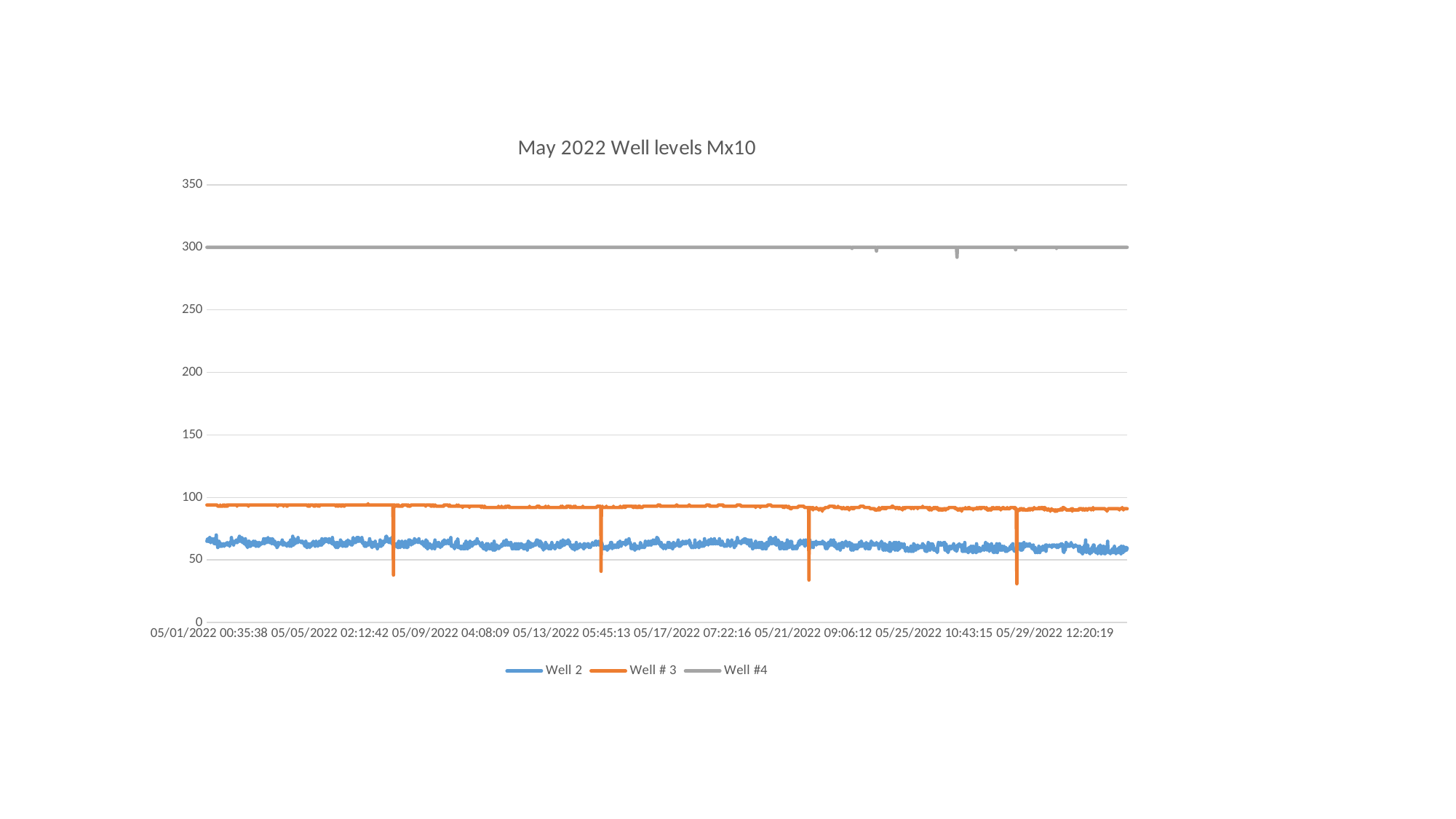
Which series has the highest values throughout the chart? Well #4 Is the typical value for Well 2 greater or less than 100? less Which series is larger, Well 2 or Well # 3? Well # 3 Which series has the lowest values throughout the chart? Well 2 How many date labels are shown on the x axis? 8 What is the title of the chart? May 2022 Well levels Mx10 What kind of chart is shown on the slide? line chart How many series does the legend list? 3 Is the typical value for Well # 3 greater or less than 150? less How many sharp downward spikes does the Well # 3 line show? 4 Which colour is used for the Well # 3 line? orange Is the value for Well #4 greater or less than 250? greater